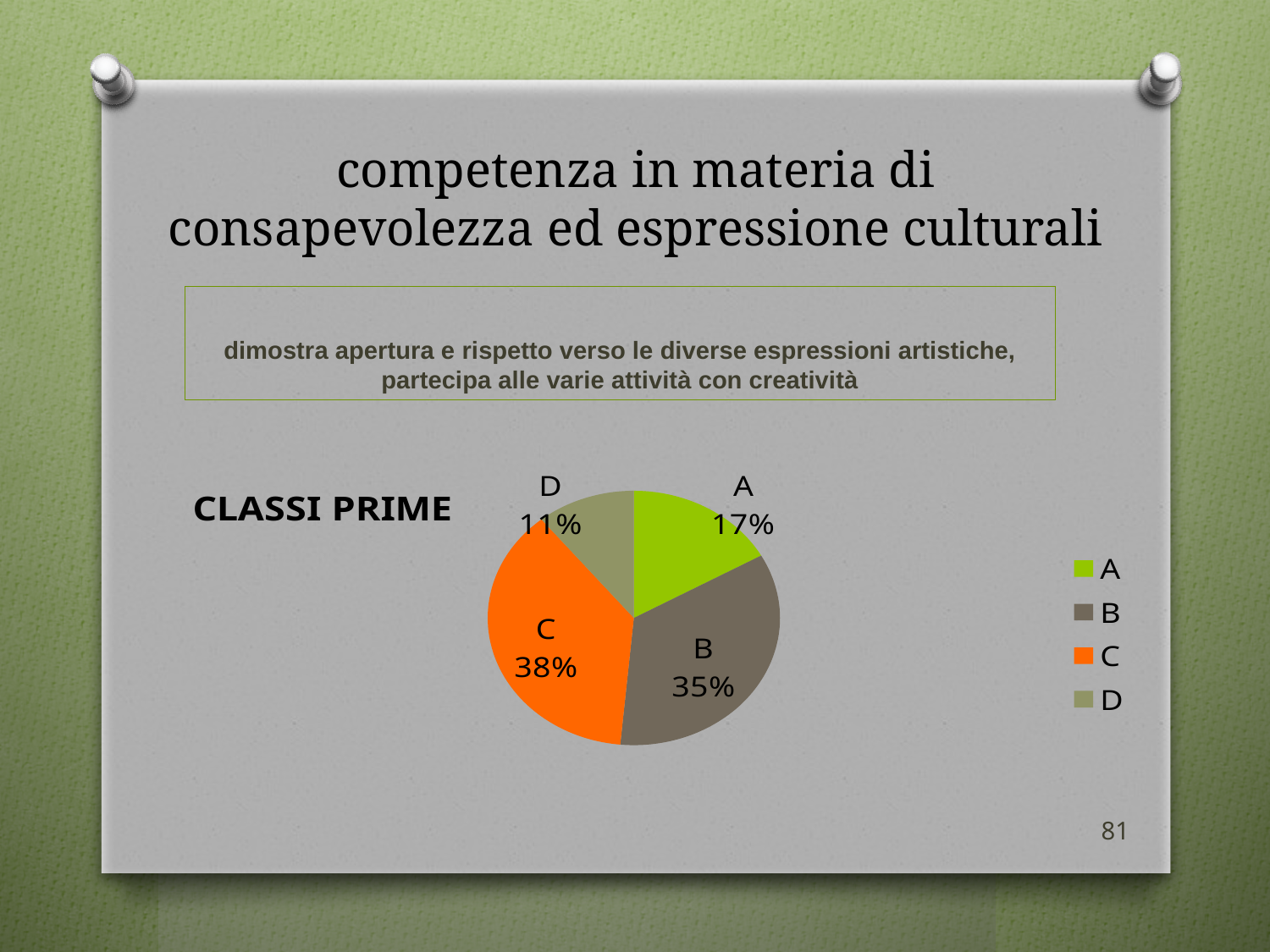
What is the difference in percentage points between category C and category A? 21 How many categories are shown in the pie chart? 4 Which category has the largest share of the pie chart? C What percentage of the pie chart does category C represent? 38% Which category has the smallest share of the pie chart? D Which category has a larger share, A or B? B What percentage of the pie chart does category D represent? 11% What percentage of the pie chart does category B represent? 35% What colour is used for category C in the pie chart? Orange What label appears to the left of the pie chart? CLASSI PRIME What type of chart is shown on the slide? Pie chart What percentage of the pie chart does category A represent? 17%